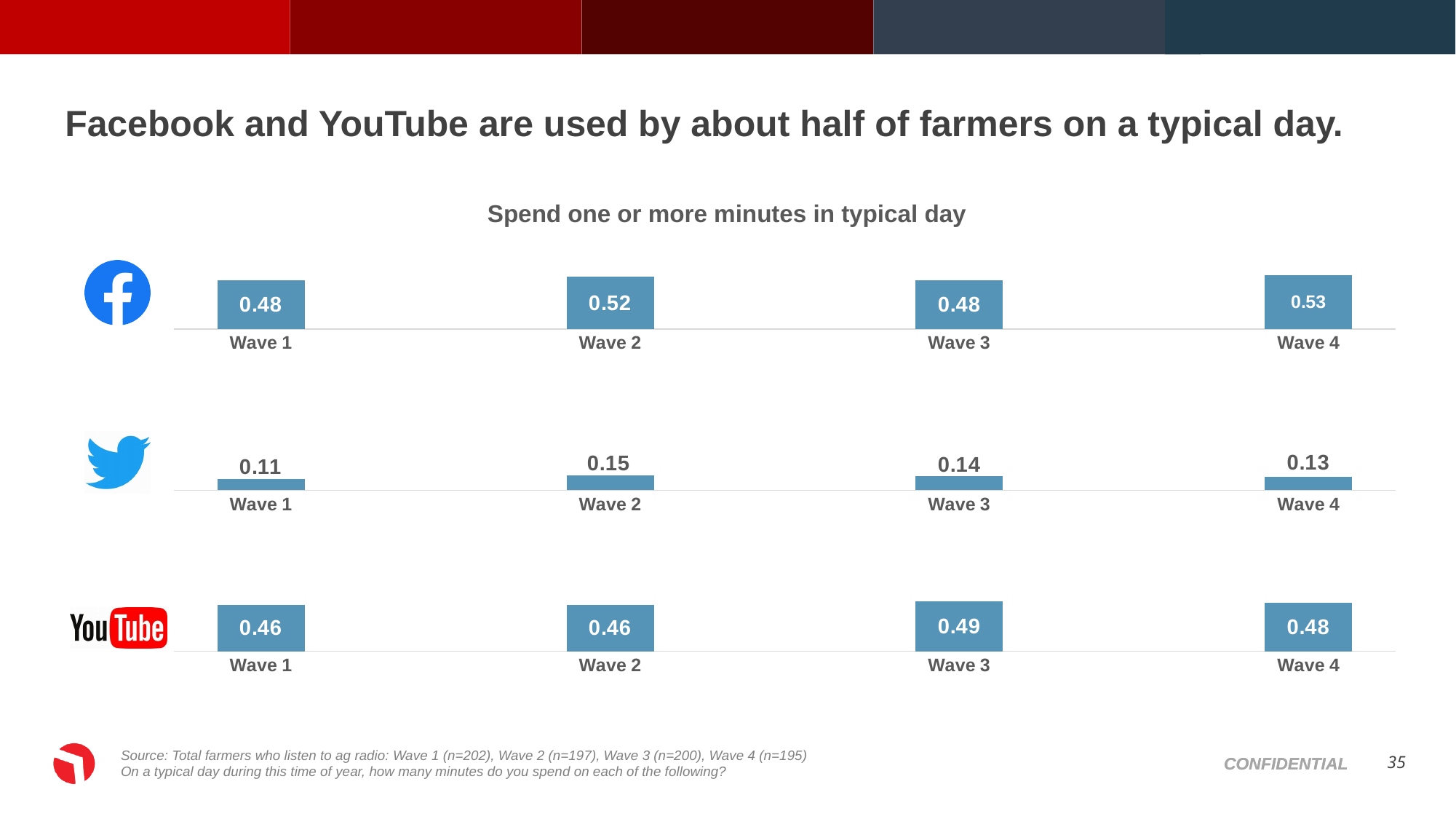
In the bottom chart (YouTube), which is larger, the value for Wave 3 or the value for Wave 1? Wave 3 In the middle chart (Twitter), which wave has the highest value? Wave 2 How many waves are shown in the bottom chart (YouTube)? 4 In the top chart (Facebook), which wave has the highest value? Wave 4 In the middle chart (Twitter), what is the value for Wave 1? 0.11 What type of chart is used for the Facebook data at the top of the slide? Bar chart What is the shared title above the three charts? Spend one or more minutes in typical day In the top chart (Facebook), what is the difference between the Wave 4 and Wave 1 values? 0.05 In the bottom chart (YouTube), what is the value for Wave 3? 0.49 In the top chart (Facebook), what is the value for Wave 2? 0.52 In the middle chart (Twitter), what is the difference between the Wave 2 and Wave 4 values? 0.02 In the middle chart (Twitter), which wave has the lowest value? Wave 1